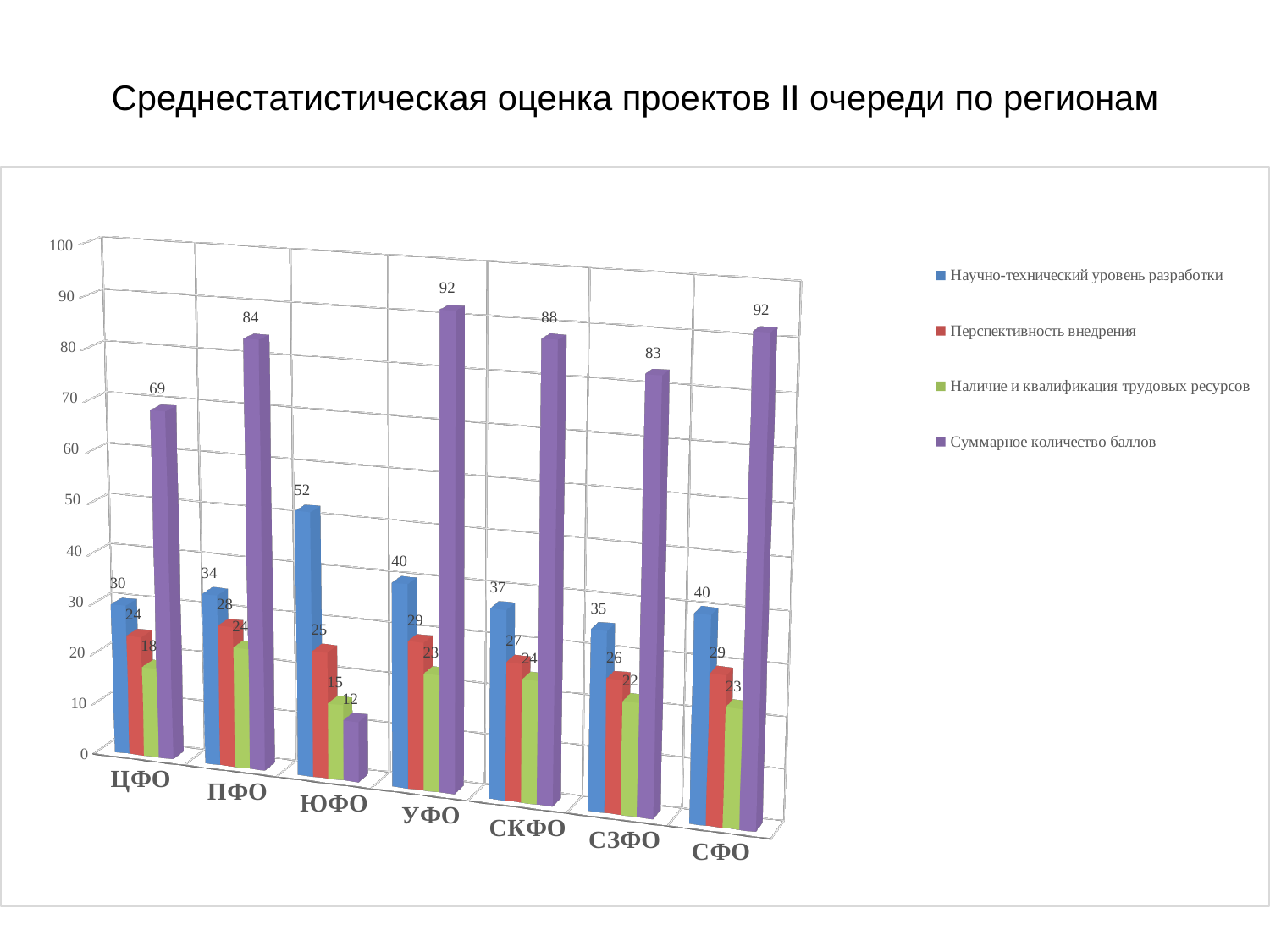
What is the difference between the 'Суммарное количество баллов' values for УФО and ЦФО? 23 How many series does the legend list? 4 How many regions (categories) are shown on the x axis? 7 Which region has the highest value for 'Научно-технический уровень разработки'? ЮФО What is the value of 'Суммарное количество баллов' for ПФО? 84 What is the title of the slide? Среднестатистическая оценка проектов II очереди по регионам What is the value of 'Перспективность внедрения' for СЗФО? 26 What is the value of 'Наличие и квалификация трудовых ресурсов' for ЦФО? 18 Which is larger: 'Научно-технический уровень разработки' for СКФО or for СЗФО? СКФО What type of chart is shown on the slide? bar chart Which region has the lowest value for 'Суммарное количество баллов'? ЮФО What is the value of 'Научно-технический уровень разработки' for ЮФО? 52